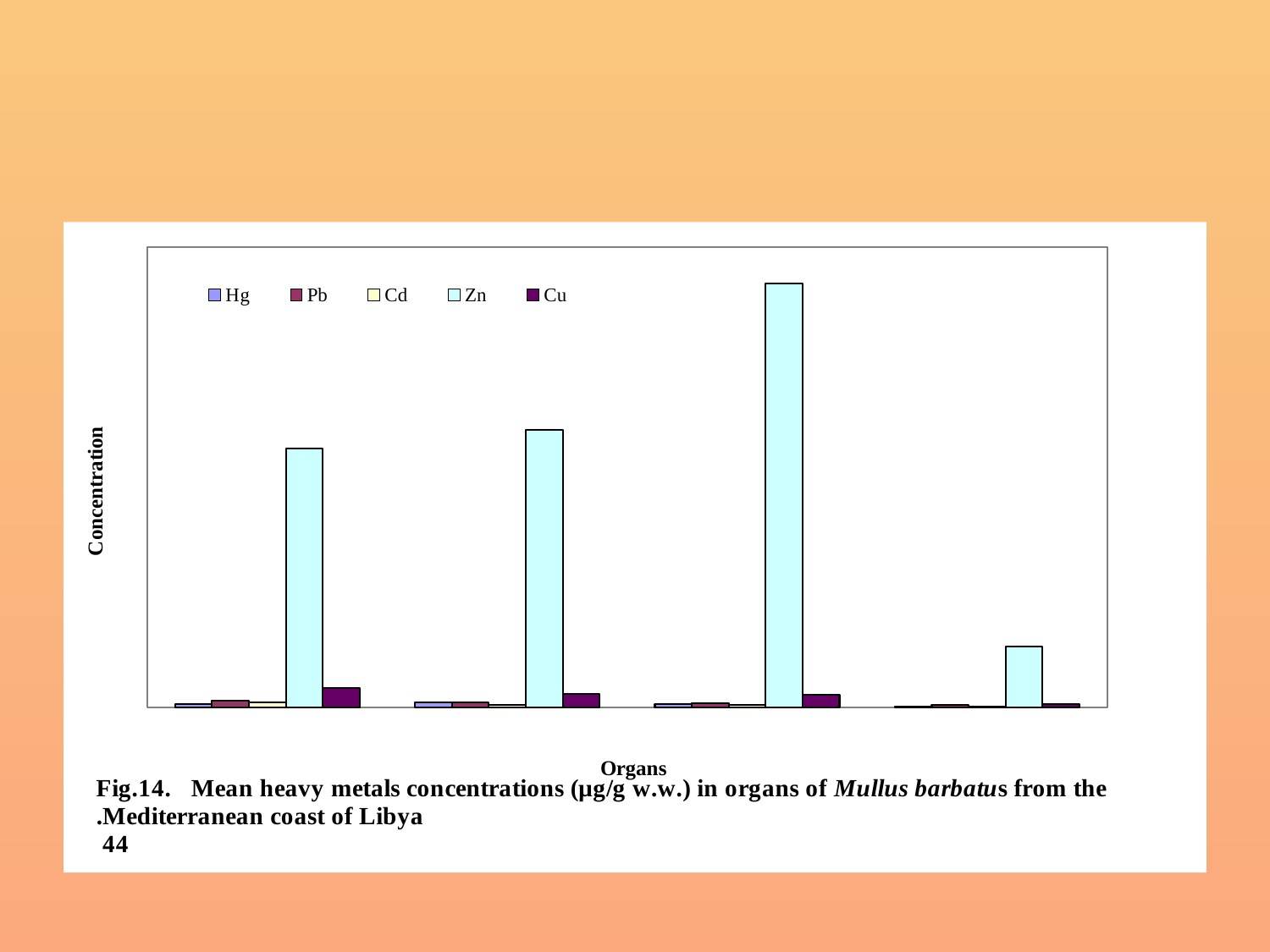
How many groups of bars (organs) are plotted along the x axis? 4 Which metal has the second-tallest bar in the first organ group from the left? Cu Which metal has the tallest bar in every organ group? Zn Is the Zn bar in the first organ group from the left taller or shorter than the Zn bar in the second group? shorter What is the title of the y axis? Concentration Which metals are listed in the legend, in order? Hg, Pb, Cd, Zn, Cu In which organ group, counting from the left, is the Zn bar the shortest? the fourth group What is the title of the x axis? Organs In which organ group, counting from the left, is the Zn bar the tallest? the third group What kind of chart is shown on the slide? bar chart How many series does the legend list? 5 In the third organ group from the left, which is larger, the Zn bar or the Cu bar? Zn